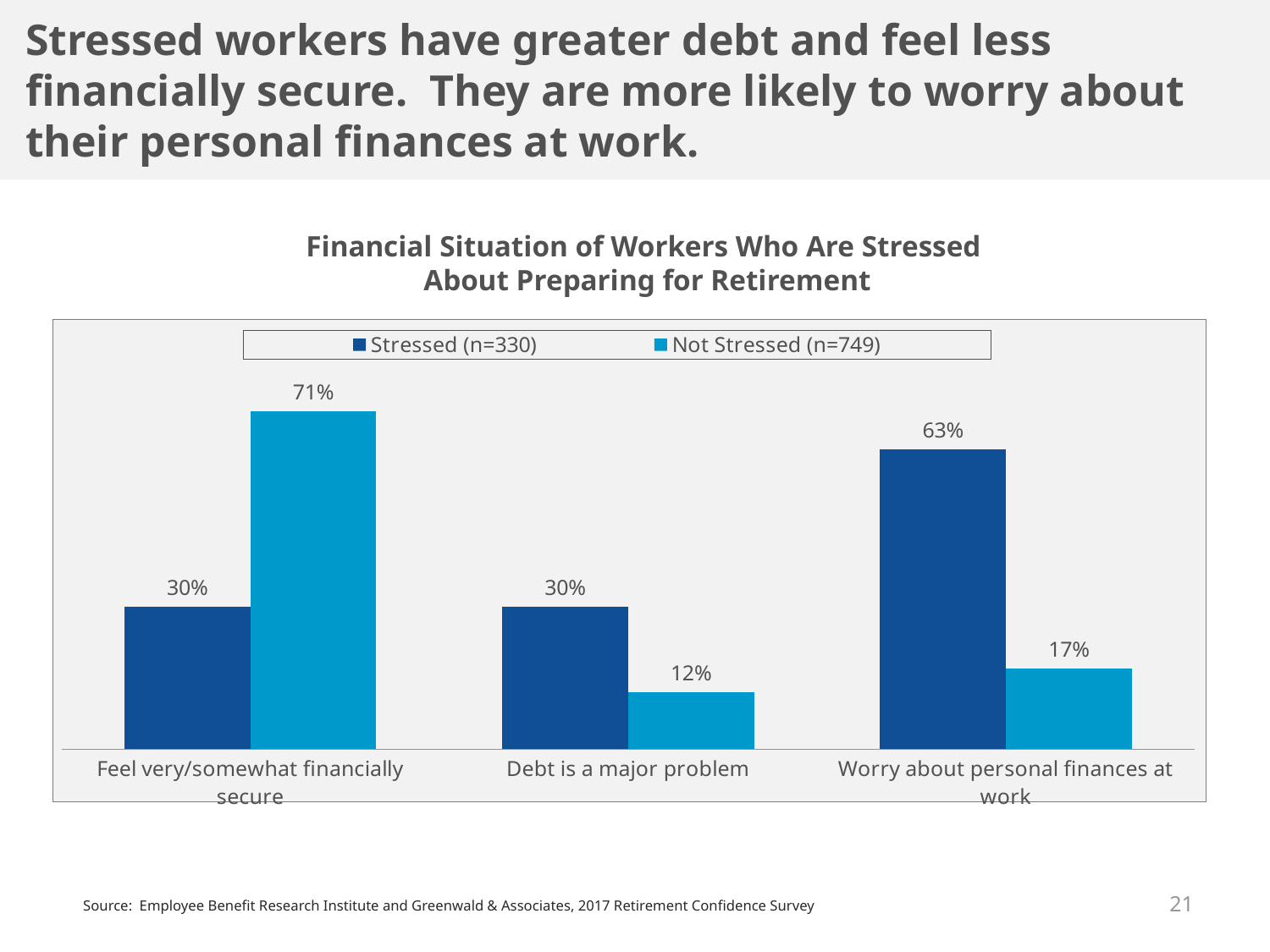
What percentage of Not Stressed workers feel very/somewhat financially secure? 71% How many categories are shown on the x axis? 3 What is the difference between the Stressed and Not Stressed values for 'Worry about personal finances at work'? 46 percentage points What percentage of Not Stressed workers say debt is a major problem? 12% What percentage of Stressed workers feel very/somewhat financially secure? 30% Which group has the larger value for 'Debt is a major problem', Stressed or Not Stressed? Stressed What type of chart is shown on the slide? Bar chart How many series does the legend list? 2 For which category is the Not Stressed value highest? Feel very/somewhat financially secure What percentage of Stressed workers worry about personal finances at work? 63% What is the sample size (n) for the Not Stressed group shown in the legend? 749